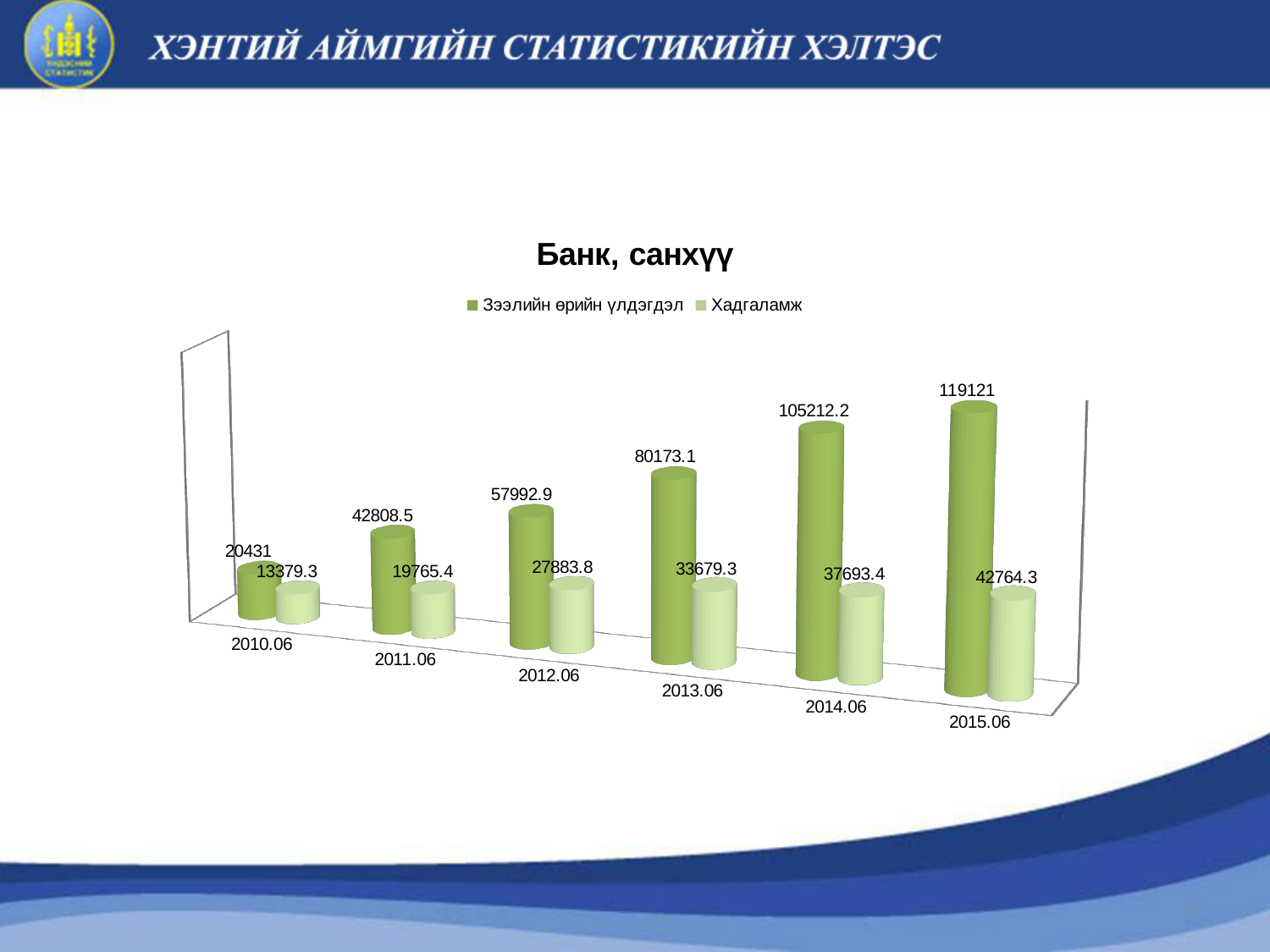
What is the value of Хадгаламж for 2012.06? 27883.8 What is the difference between Зээлийн өрийн үлдэгдэл and Хадгаламж in 2015.06? 76356.7 What is the value of Зээлийн өрийн үлдэгдэл for 2015.06? 119121 In which year is Хадгаламж lowest? 2010.06 What is the value of Хадгаламж for 2010.06? 13379.3 What kind of chart is shown on the slide? Bar chart What is the value of Зээлийн өрийн үлдэгдэл for 2013.06? 80173.1 How many years (categories) are shown on the x axis? 6 How many series does the legend list? 2 By how much did Хадгаламж increase from 2010.06 to 2015.06? 29385 Which is larger in 2014.06: Зээлийн өрийн үлдэгдэл or Хадгаламж? Зээлийн өрийн үлдэгдэл In which year is Зээлийн өрийн үлдэгдэл highest? 2015.06